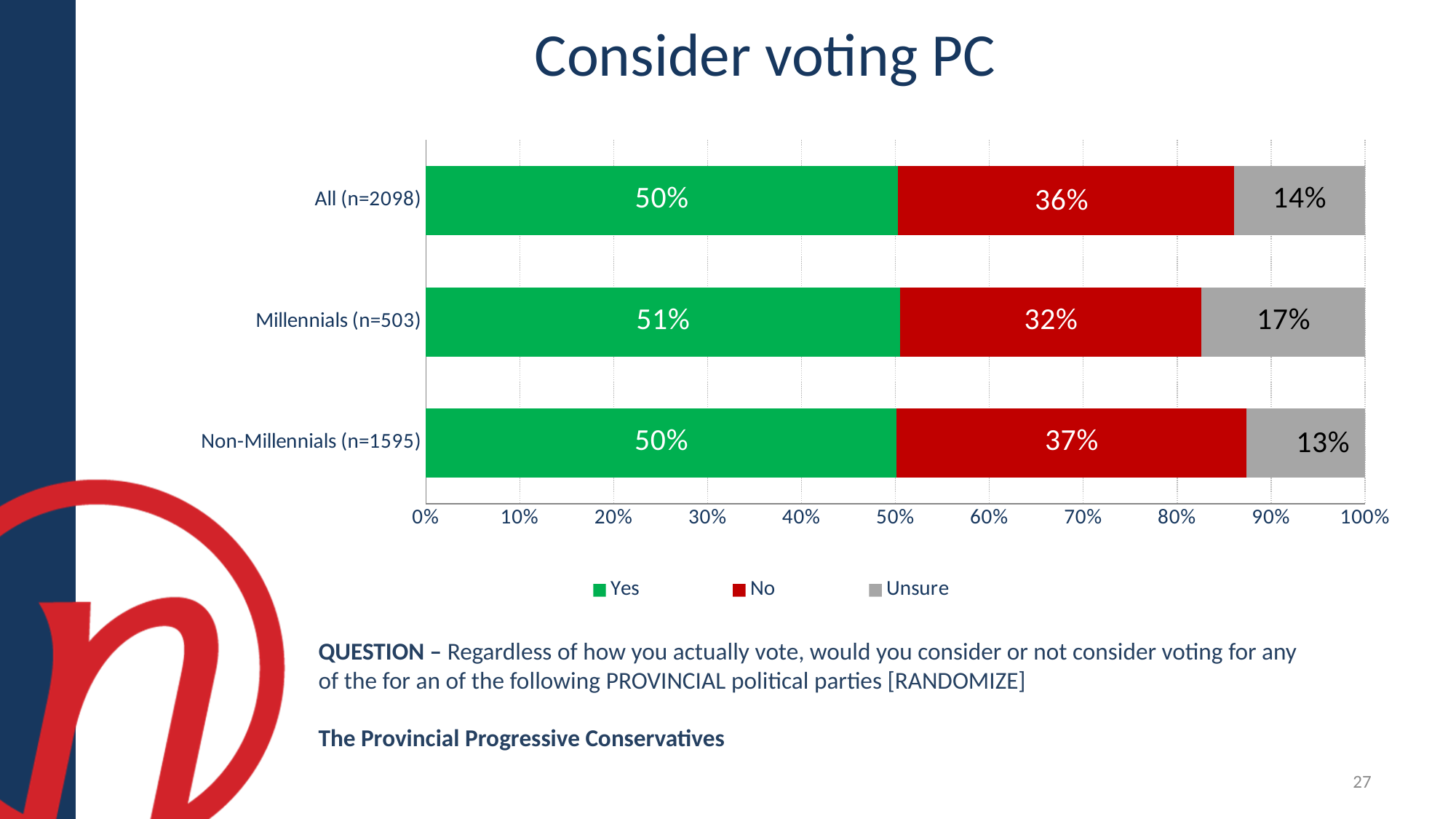
What percentage of All (n=2098) answered Yes? 50% What percentage of Non-Millennials (n=1595) answered Unsure? 13% Which group has the lowest No percentage? Millennials (n=503) Which colour represents the No responses? Red What is the difference between the No percentage for Non-Millennials (n=1595) and Millennials (n=503)? 5% How many series does the legend list? 3 Which group has the highest Unsure percentage? Millennials (n=503) What percentage of Millennials (n=503) answered No? 32% How many groups are shown on the chart? 3 What is the title of the chart? Consider voting PC What kind of chart is shown on the slide? Stacked bar chart Is the Unsure percentage higher for Millennials (n=503) or Non-Millennials (n=1595)? Millennials (n=503)